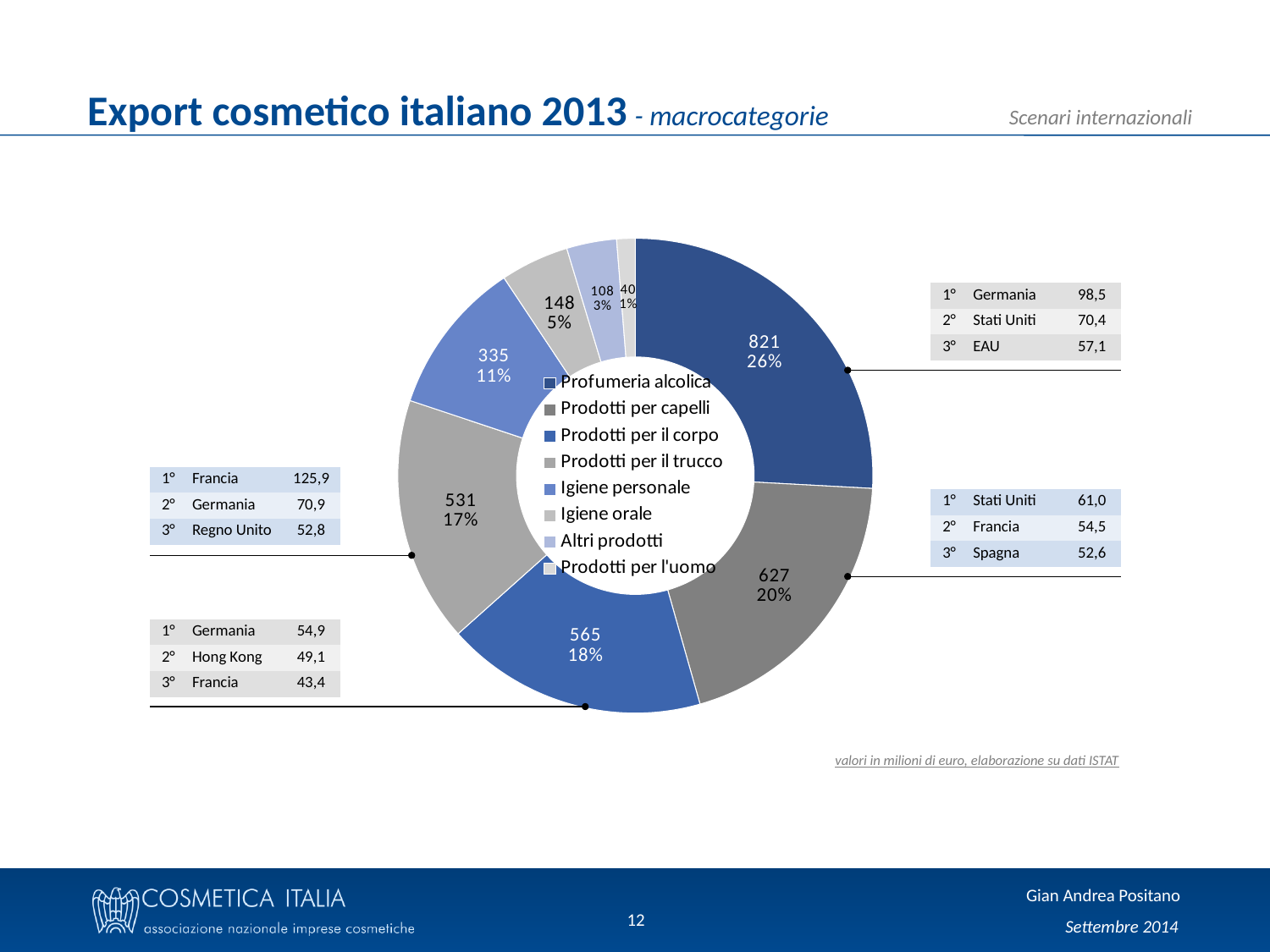
What is the value shown for the slice labelled 18%? 565 What percentage is shown for the slice with value 108? 3% What type of chart is shown on the slide? doughnut (pie) chart Which is larger, the slice with 335 or the slice with 148? 335 What share of the total does the 531 slice represent? 17% How many categories does the chart's legend list? 8 What is the title of the slide containing the chart? Export cosmetico italiano 2013 - macrocategorie What is the difference between the 821 slice and the 627 slice? 194 What is the value of the smallest slice of the chart? 40 What share of the total does the 821 slice represent? 26% Which category has the largest slice of the chart? Profumeria alcolica What is the value of the largest slice of the chart? 821